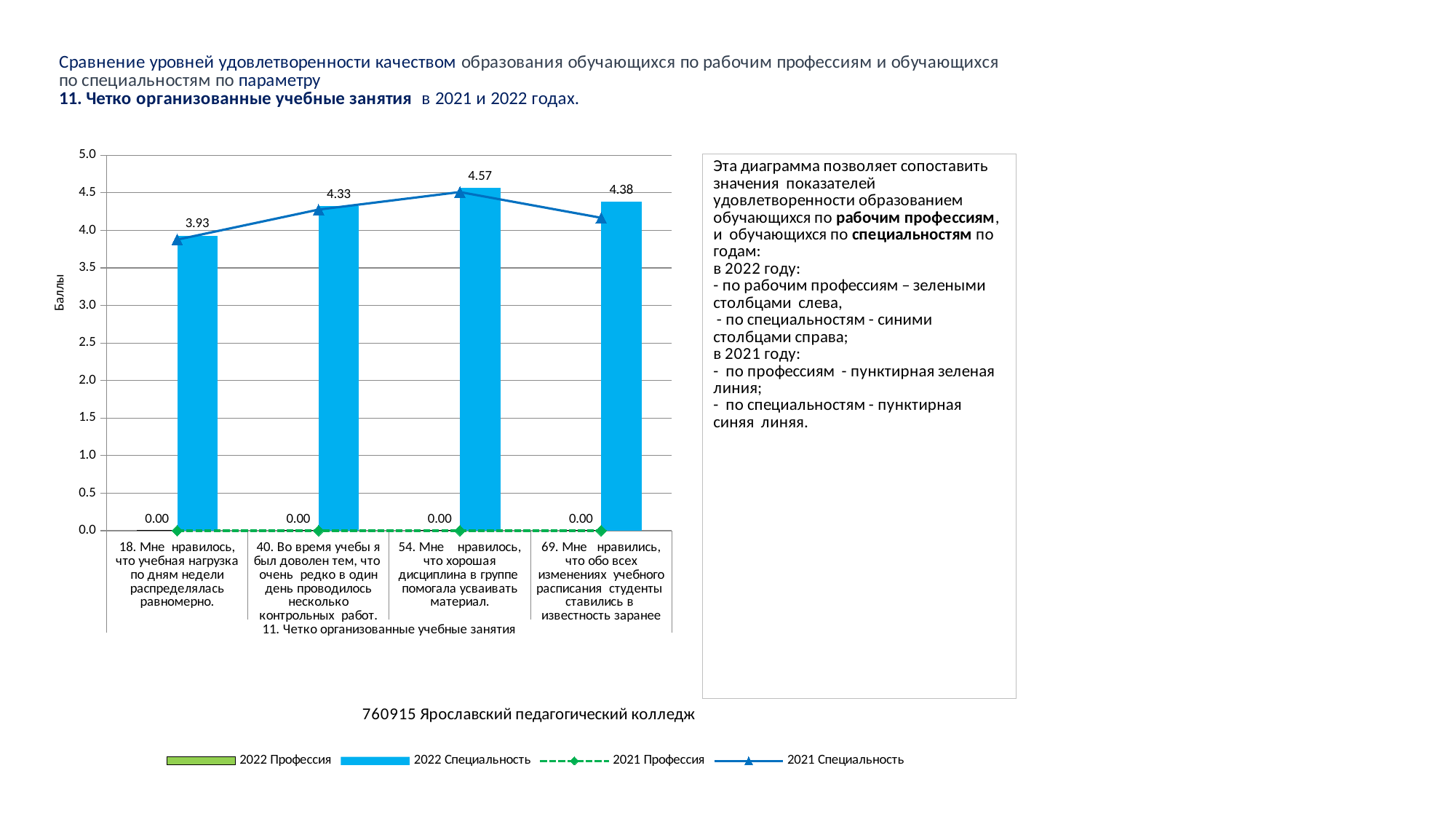
What is the value of the 2022 Специальность bar for category 69 (Мне нравились, что обо всех изменениях учебного расписания студенты ставились в известность заранее)? 4.38 What is the difference between the 2022 Специальность values for category 54 and category 18? 0.64 Which category has the highest 2022 Специальность bar? 54. Мне нравилось, что хорошая дисциплина в группе помогала усваивать материал. Which is larger, the 2022 Специальность value for category 40 or for category 69? Category 69 (4.38) Which category has the lowest 2022 Специальность bar? 18. Мне нравилось, что учебная нагрузка по дням недели распределялась равномерно. What is the value of the 2022 Специальность bar for category 54 (Мне нравилось, что хорошая дисциплина в группе помогала усваивать материал)? 4.57 What is the value of the 2022 Специальность bar for category 18 (Мне нравилось, что учебная нагрузка по дням недели распределялась равномерно)? 3.93 What value is labelled for the 2022 Профессия series in each category? 0.00 How many categories are shown on the x axis? 4 Is the 2021 Специальность value for category 54 greater or less than 4.0? greater What is the label of the vertical axis? Баллы How many series does the legend list? 4